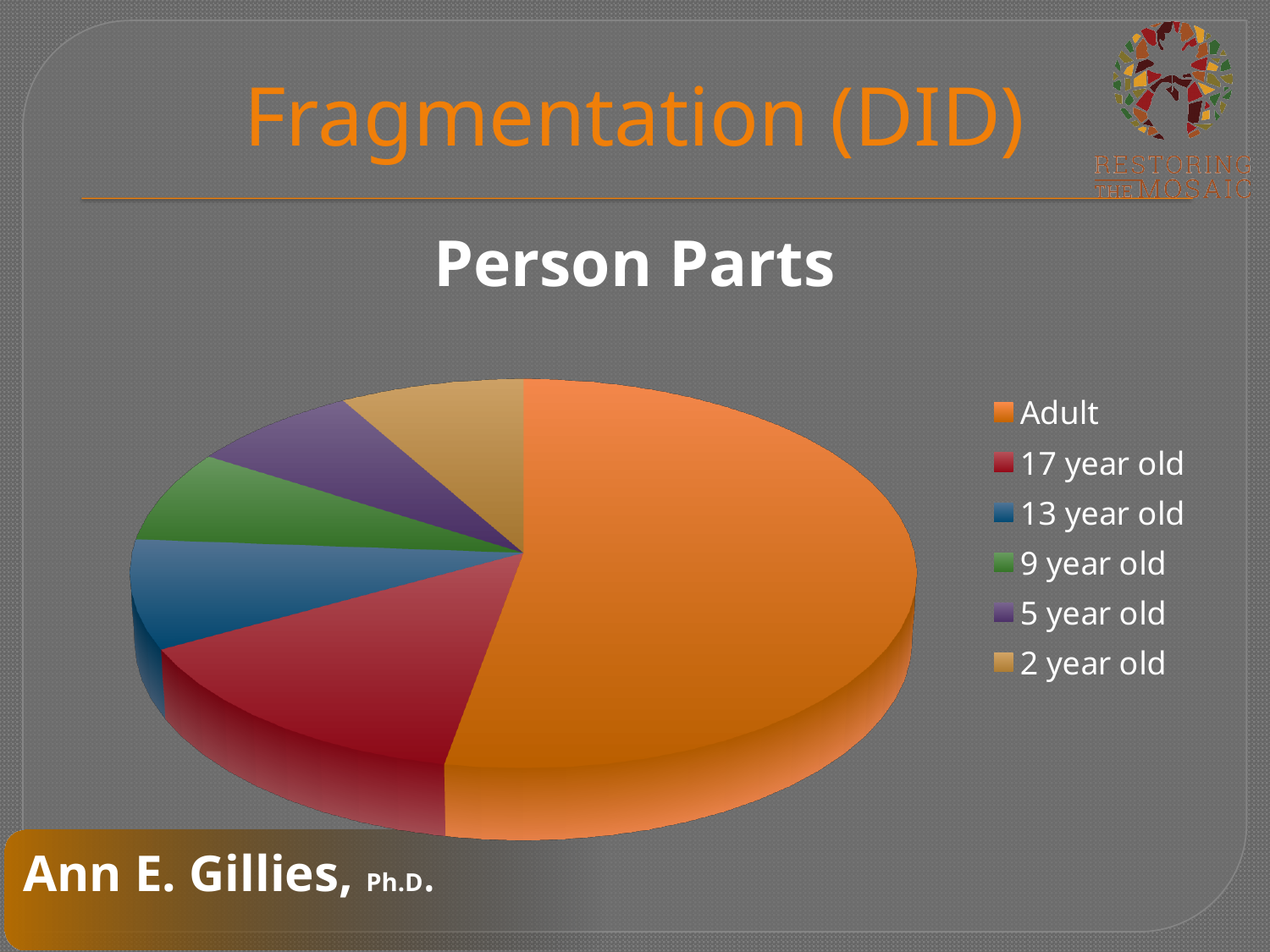
Which slice is larger, 17 year old or 13 year old? 17 year old Which slice is larger, Adult or 17 year old? Adult How many slices does the pie chart have? 6 What kind of chart is shown on the slide? Pie chart What is the title of the chart? Person Parts Which slice is larger, 17 year old or 9 year old? 17 year old What colour is the Adult slice? Orange How many entries does the legend list? 6 Which category has the largest slice of the pie? Adult